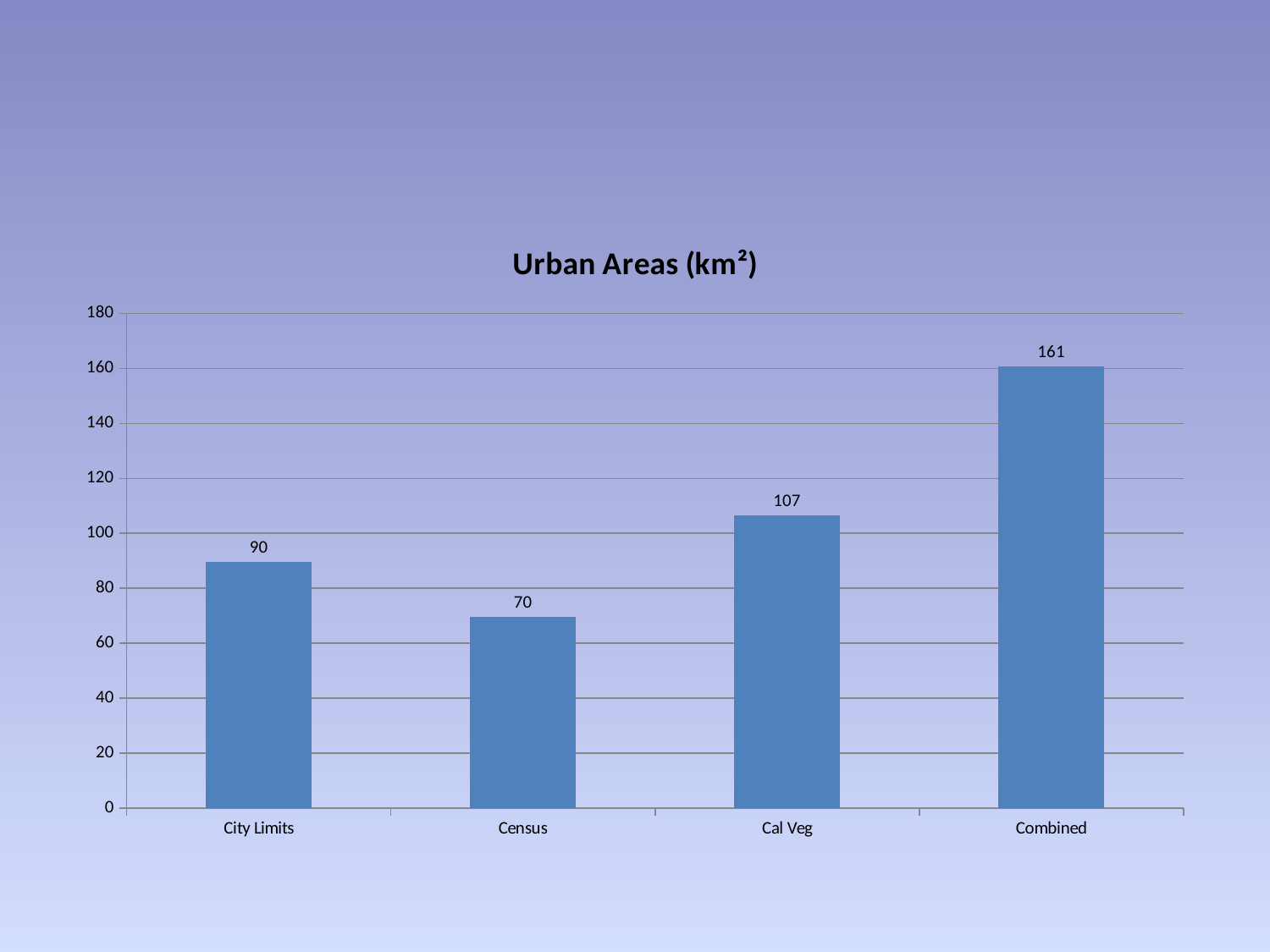
What kind of chart is shown on the slide? Bar chart Which category has the highest value? Combined Which category has the lowest value? Census What is the value for City Limits? 90 Which is larger, the value for Cal Veg or the value for City Limits? Cal Veg What is the value for Cal Veg? 107 What is the value for Combined? 161 What is the value for Census? 70 Is the value for Combined greater or less than 140? greater How many categories are shown on the x axis? 4 What is the difference between the values for Combined and Cal Veg? 54 What is the difference between the values for City Limits and Census? 20